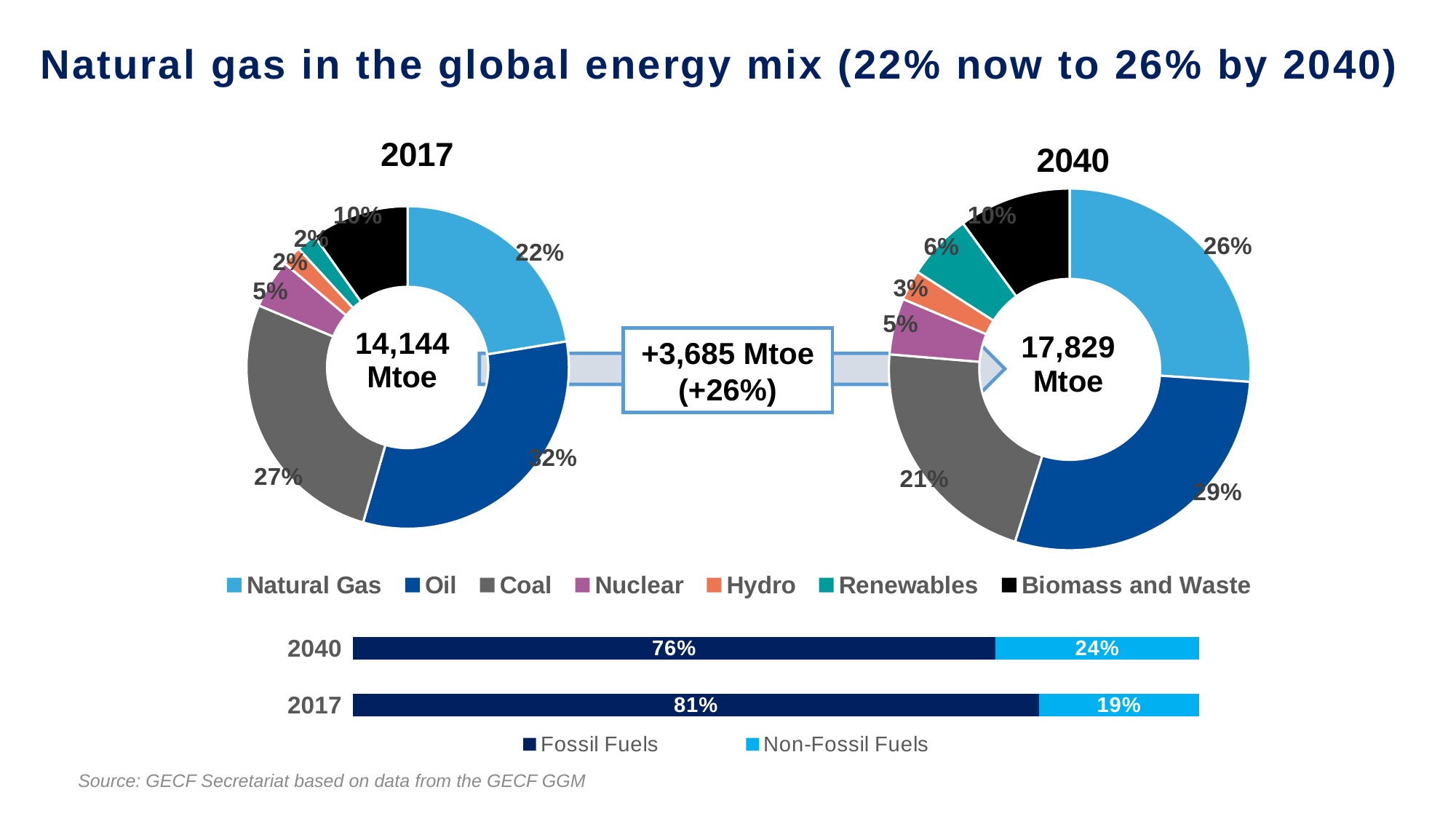
What is the difference between the Coal share in 2017 and the Coal share in 2040? 6% In the 2040 donut chart, what share does Renewables have? 6% In the stacked bar chart at the bottom, what share do Fossil Fuels have in 2040? 76% In the 2040 donut chart, which is larger, the share of Natural Gas or the share of Coal? Natural Gas In the 2017 donut chart, what share does Natural Gas have? 22% What kind of chart is shown at the bottom of the slide for Fossil Fuels and Non-Fossil Fuels? Stacked bar chart In the 2017 donut chart, which energy source has the largest share? Oil In the 2040 donut chart, what share does Oil have? 29% In the stacked bar chart at the bottom, what is the difference between the Non-Fossil Fuels share in 2040 and in 2017? 5% How many energy sources does the legend of the donut charts list? 7 What total energy value is shown in the centre of the 2040 donut chart? 17,829 Mtoe In the 2040 donut chart, which energy source has the smallest share? Hydro